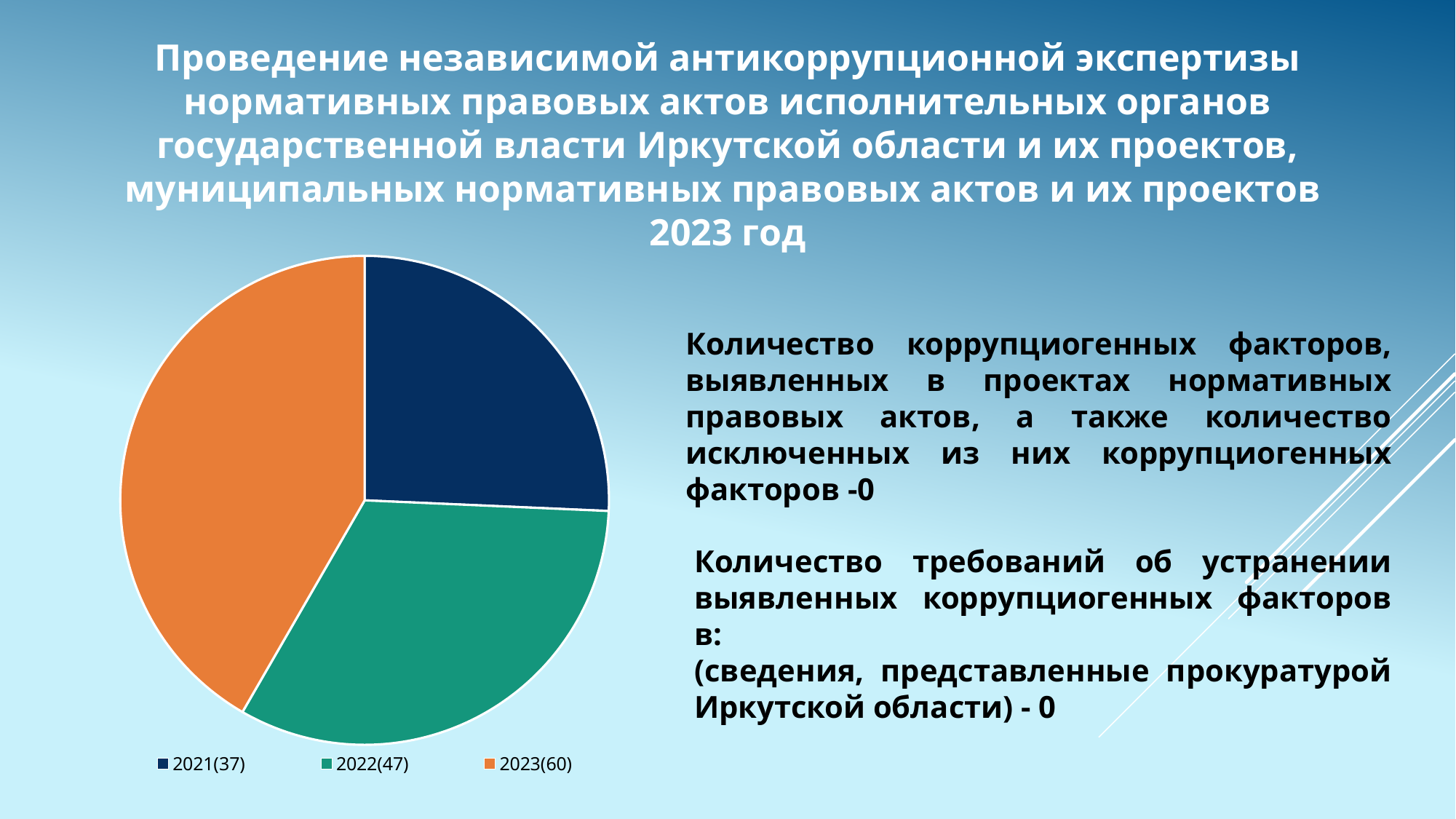
What is the difference between the values for 2023 and 2021 in the pie chart? 23 What colour is the slice for 2023 in the pie chart? orange Which year has the largest slice in the pie chart? 2023 What value is shown for 2023 in the pie chart legend? 60 What value is shown for 2021 in the pie chart legend? 37 Which is larger in the pie chart, the value for 2022 or the value for 2021? 2022 Which year has the smallest slice in the pie chart? 2021 Do the values in the pie chart rise or fall from 2021 to 2023? rise How many entries does the legend of the pie chart list? 3 What value is shown for 2022 in the pie chart legend? 47 What kind of chart is shown on the slide? pie chart How many slices does the pie chart have? 3